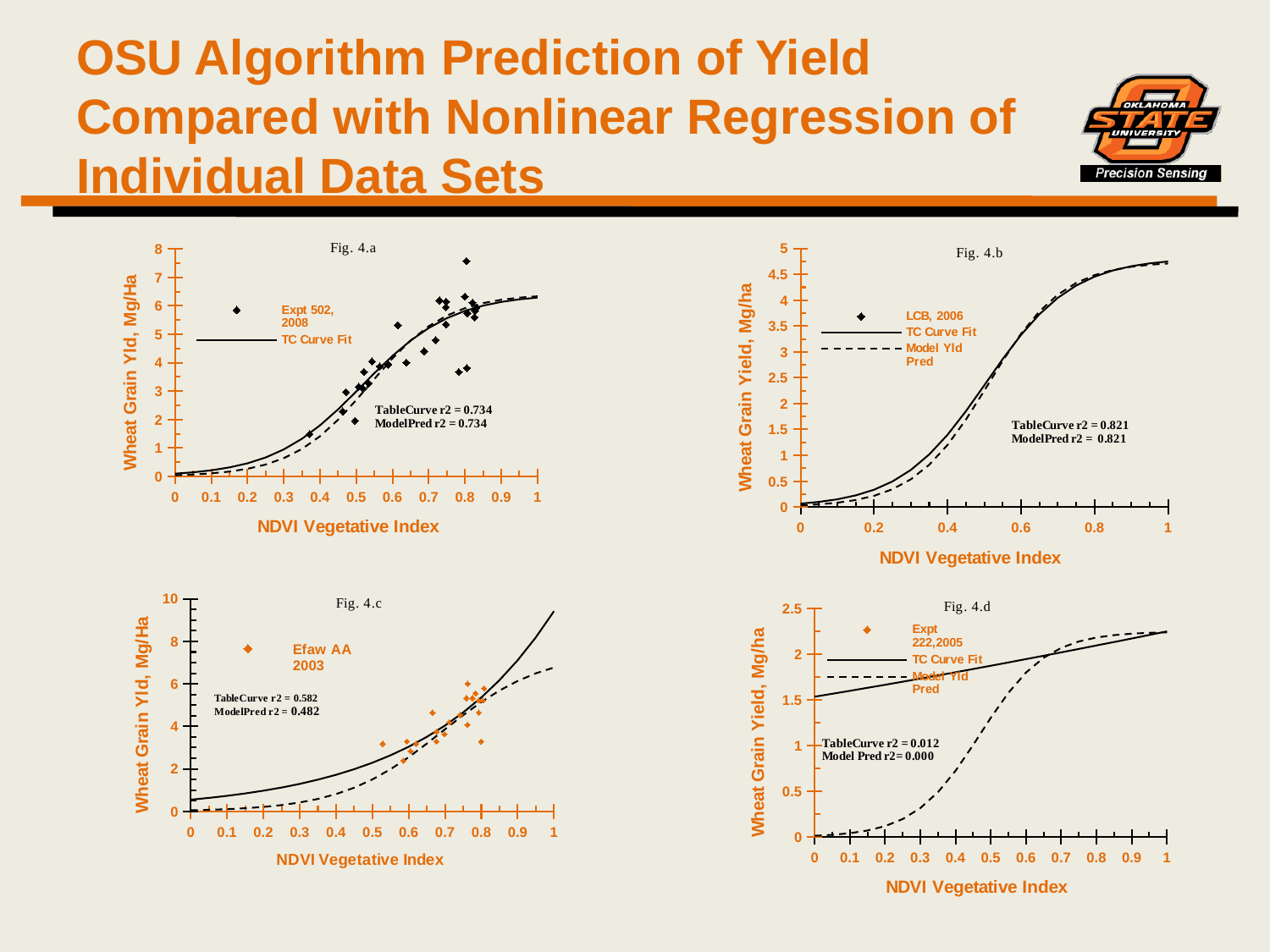
In Fig. 4.c, what is the difference between the TableCurve r2 and the ModelPred r2? 0.100 In Fig. 4.d, what is the TableCurve r2 value? 0.012 In Fig. 4.a, what is the TableCurve r2 value printed on the chart? 0.734 In Fig. 4.c, what is the ModelPred r2 value? 0.482 In Fig. 4.b, does the TC Curve Fit rise or fall as the NDVI Vegetative Index increases? rise In Fig. 4.c, which is larger, the TableCurve r2 or the ModelPred r2? TableCurve r2 How many entries does the legend in Fig. 4.b list? 3 In Fig. 4.b, what is the ModelPred r2 value? 0.821 Across the four figures, which figure reports the lowest TableCurve r2? Fig. 4.d What kind of chart is Fig. 4.a? scatter plot with fitted curve Across the four figures, which figure reports the highest TableCurve r2? Fig. 4.b In Fig. 4.d, is the Model Yld Pred value at NDVI 0.4 greater or less than 1? less